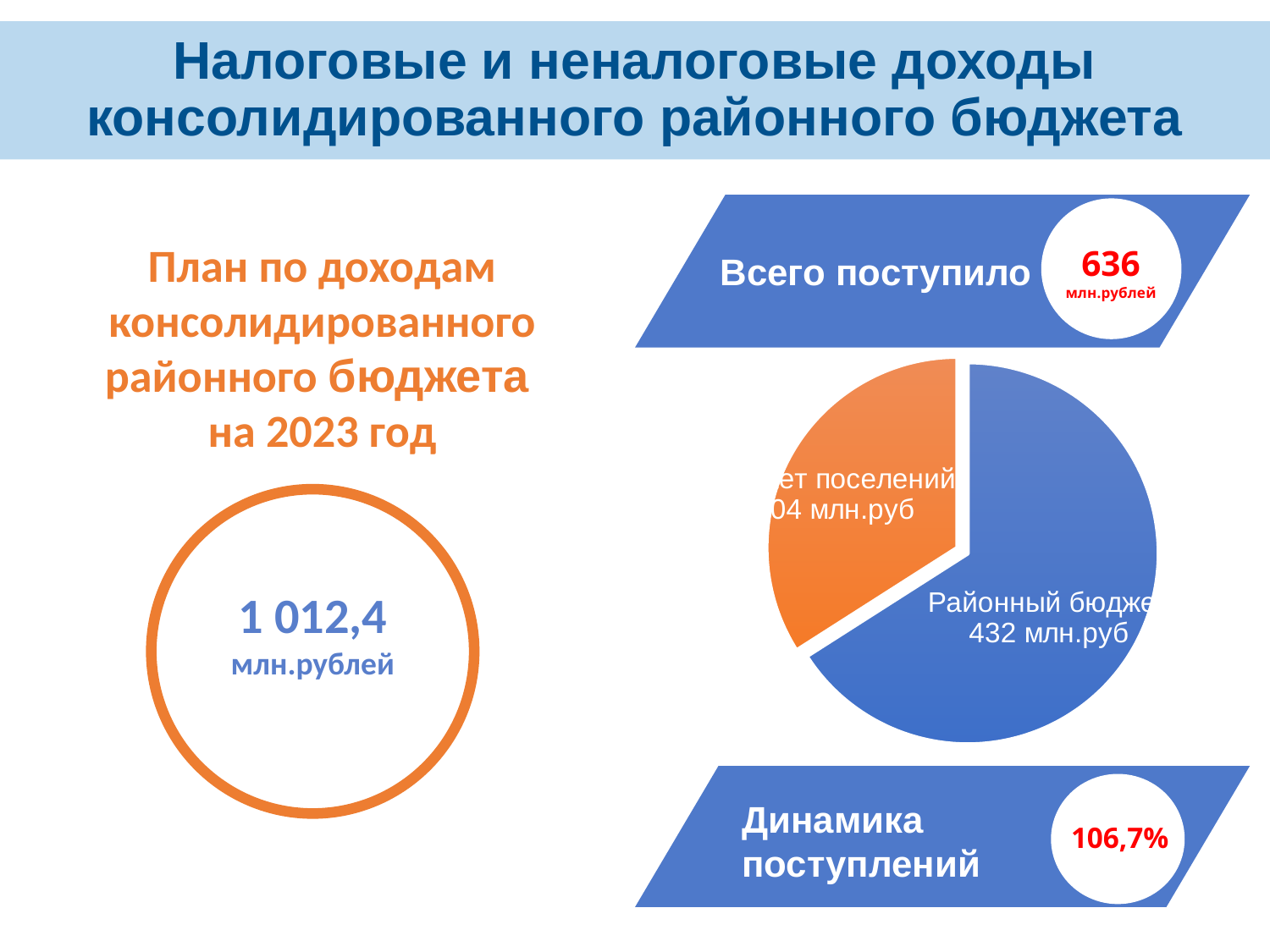
What kind of chart is shown on the slide? pie chart What colour is the Районный бюджет slice in the pie chart? blue What total amount is shown next to 'Всего поступило' above the pie chart? 636 млн.рублей Is the value for Районный бюджет greater or less than 400 млн.руб? greater Which slice of the pie chart is the largest? Районный бюджет What is the value shown for Районный бюджет in the pie chart? 432 млн.руб How many slices does the pie chart have? 2 Which slice of the pie chart is larger, the blue one or the orange one? the blue one